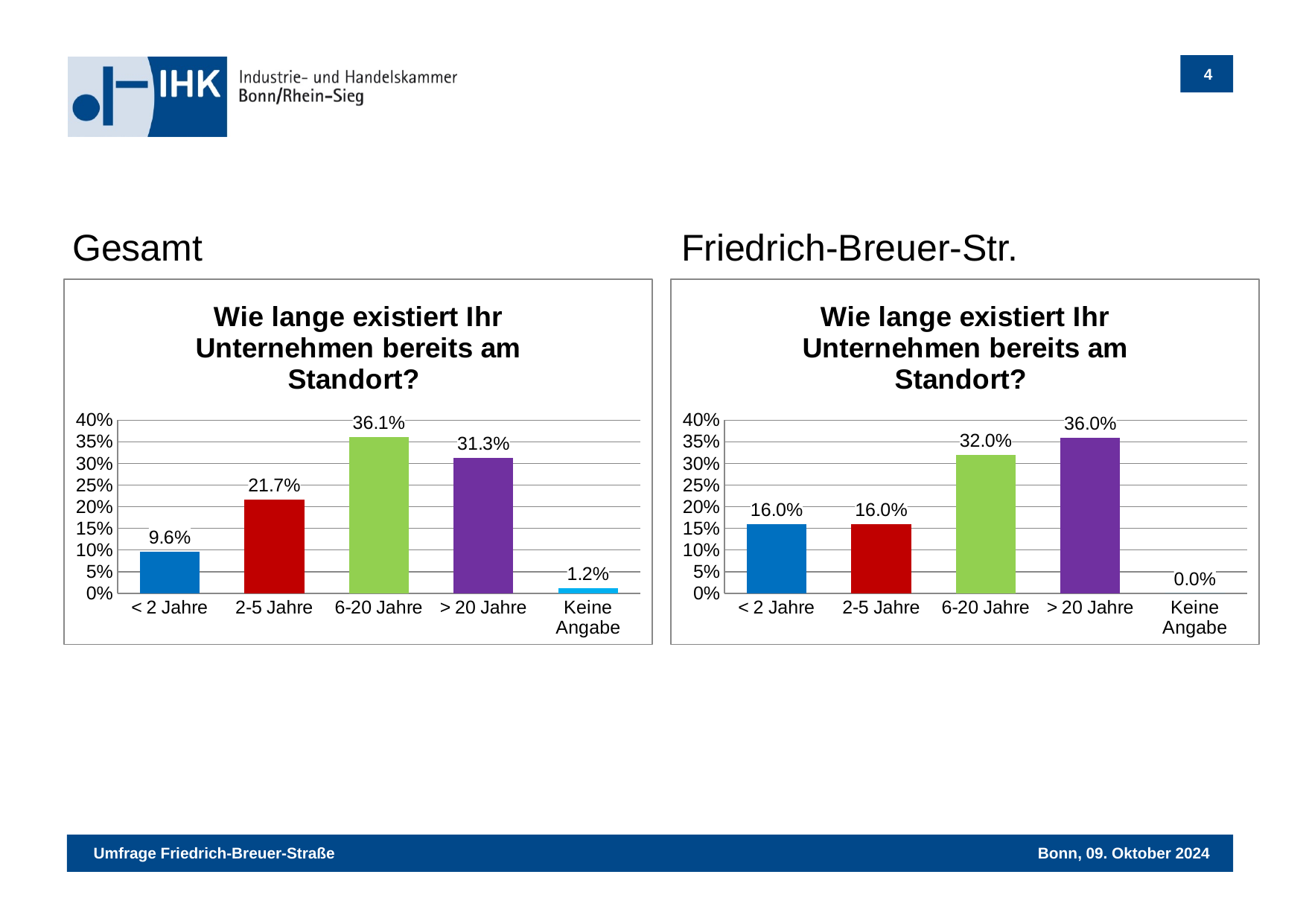
In the Gesamt chart, which is larger: the value for 2-5 Jahre or the value for < 2 Jahre? 2-5 Jahre In the Gesamt chart, which category has the highest value? 6-20 Jahre What is the title of the Friedrich-Breuer-Str. chart? Wie lange existiert Ihr Unternehmen bereits am Standort? In the Friedrich-Breuer-Str. chart, what is the value for > 20 Jahre? 36.0% In the Friedrich-Breuer-Str. chart, which category has the lowest value? Keine Angabe What kind of chart is the Gesamt chart? Bar chart In the Gesamt chart, what is the value for Keine Angabe? 1.2% In the Friedrich-Breuer-Str. chart, what is the value for 2-5 Jahre? 16.0% In the Gesamt chart, what is the value for 6-20 Jahre? 36.1% How many categories are shown on the x axis of the Friedrich-Breuer-Str. chart? 5 In the Friedrich-Breuer-Str. chart, what is the difference between the values for > 20 Jahre and 6-20 Jahre? 4.0% In the Gesamt chart, what is the difference between the values for 6-20 Jahre and > 20 Jahre? 4.8%